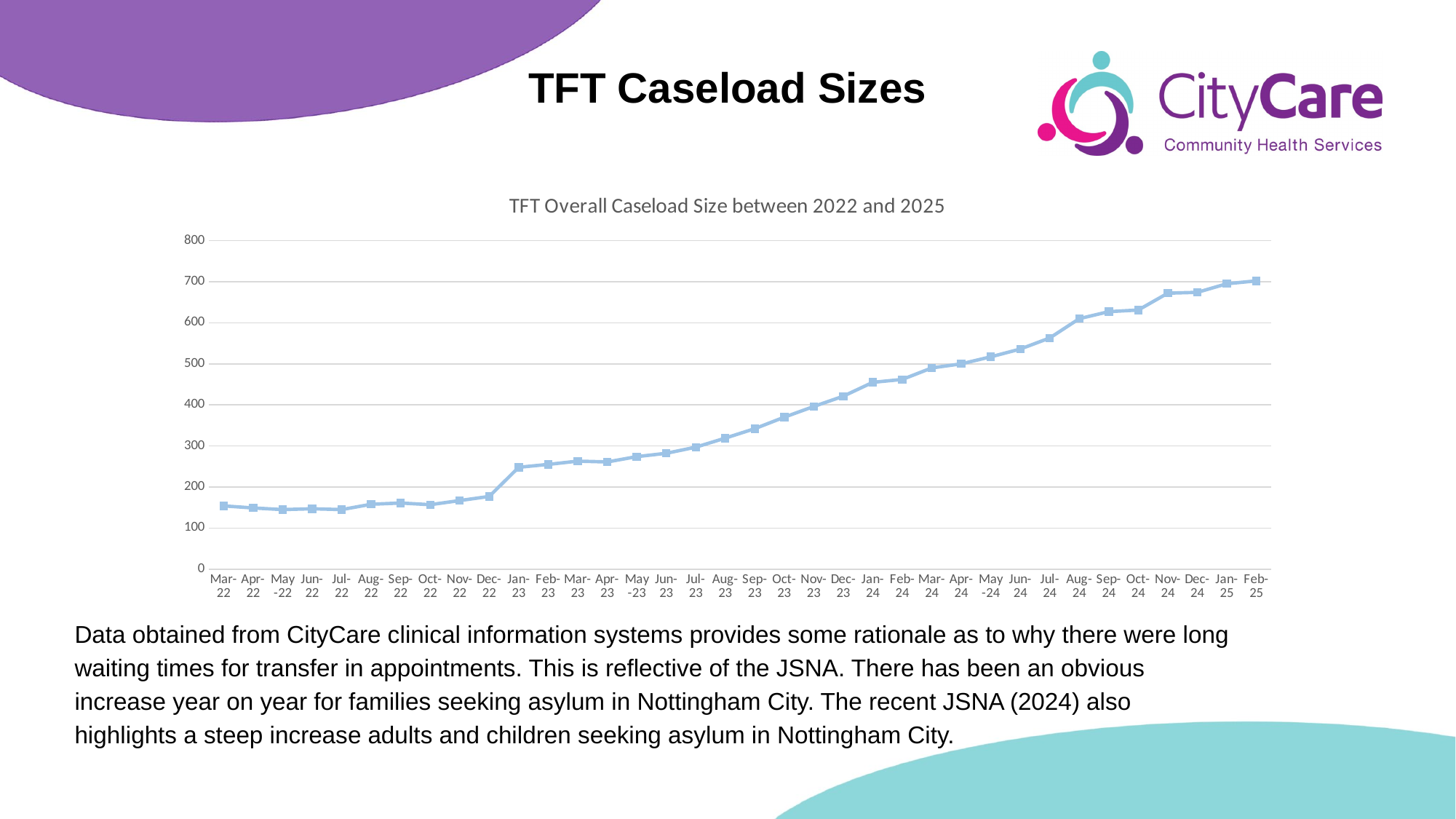
Is the value for Jan-24 greater or less than 500? less Do the caseload values generally rise or fall from Mar-22 to Feb-25? rise What is the title of the chart? TFT Overall Caseload Size between 2022 and 2025 Is the value for Oct-23 greater or less than 400? less Is the value for Mar-22 greater or less than 100? greater How many monthly data points are plotted on the chart? 36 Which month has the highest caseload size? Feb-25 What kind of chart is shown on the slide? line chart Which is larger, the value for Dec-22 or the value for Jan-23? Jan-23